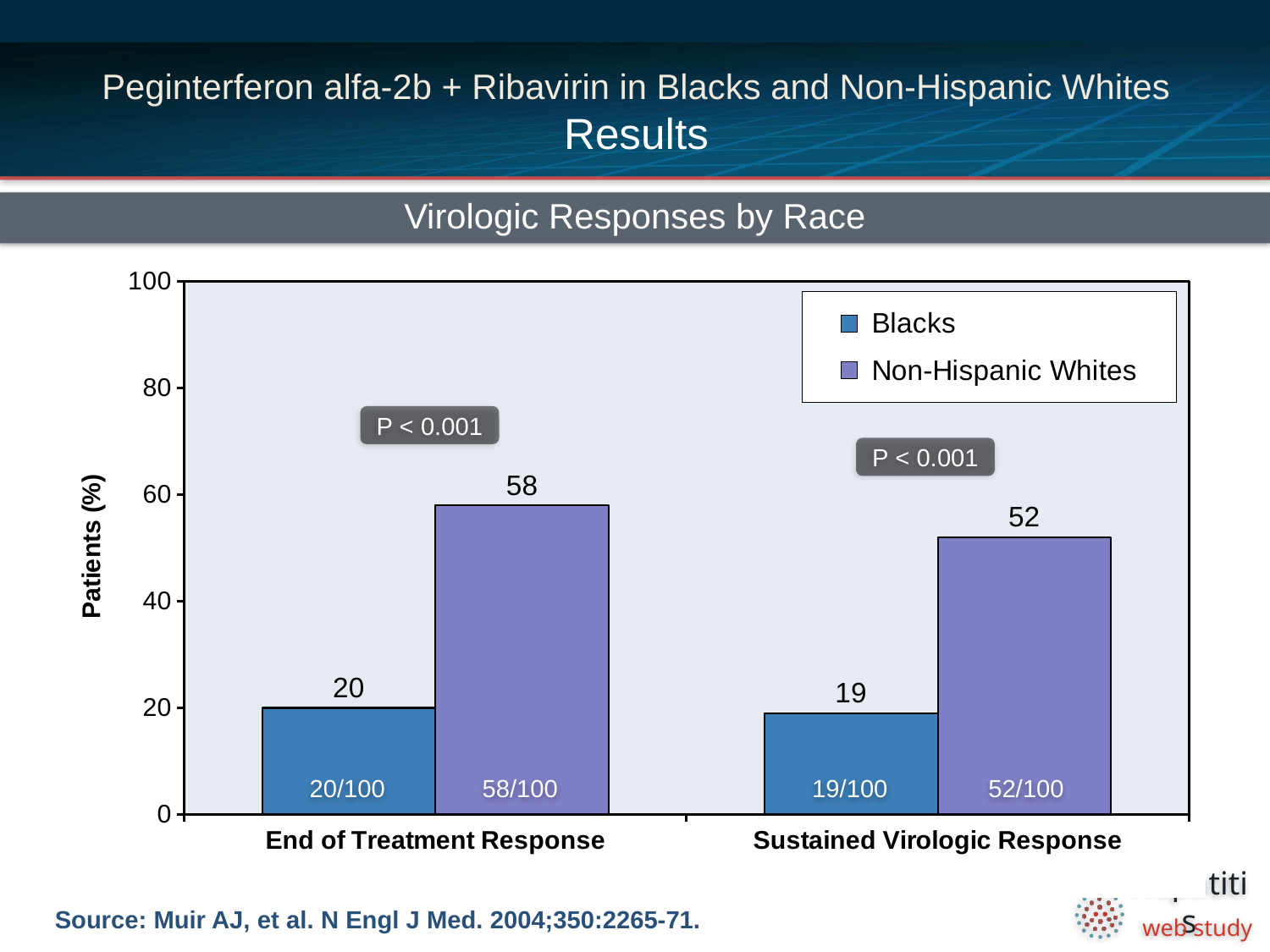
What kind of chart is shown on the slide? Bar chart What is the value for Blacks in the End of Treatment Response category? 20 Which bar has the highest value on the chart? Non-Hispanic Whites, End of Treatment Response Which is larger in the Sustained Virologic Response category: Blacks or Non-Hispanic Whites? Non-Hispanic Whites What is the value for Non-Hispanic Whites in the Sustained Virologic Response category? 52 How many series does the legend list? 2 What is the difference between Non-Hispanic Whites and Blacks in the End of Treatment Response category? 38 What is the label of the y axis? Patients (%) What is the value for Non-Hispanic Whites in the End of Treatment Response category? 58 Which bar has the lowest value on the chart? Blacks, Sustained Virologic Response How many categories are shown on the x axis? 2 What is the value for Blacks in the Sustained Virologic Response category? 19